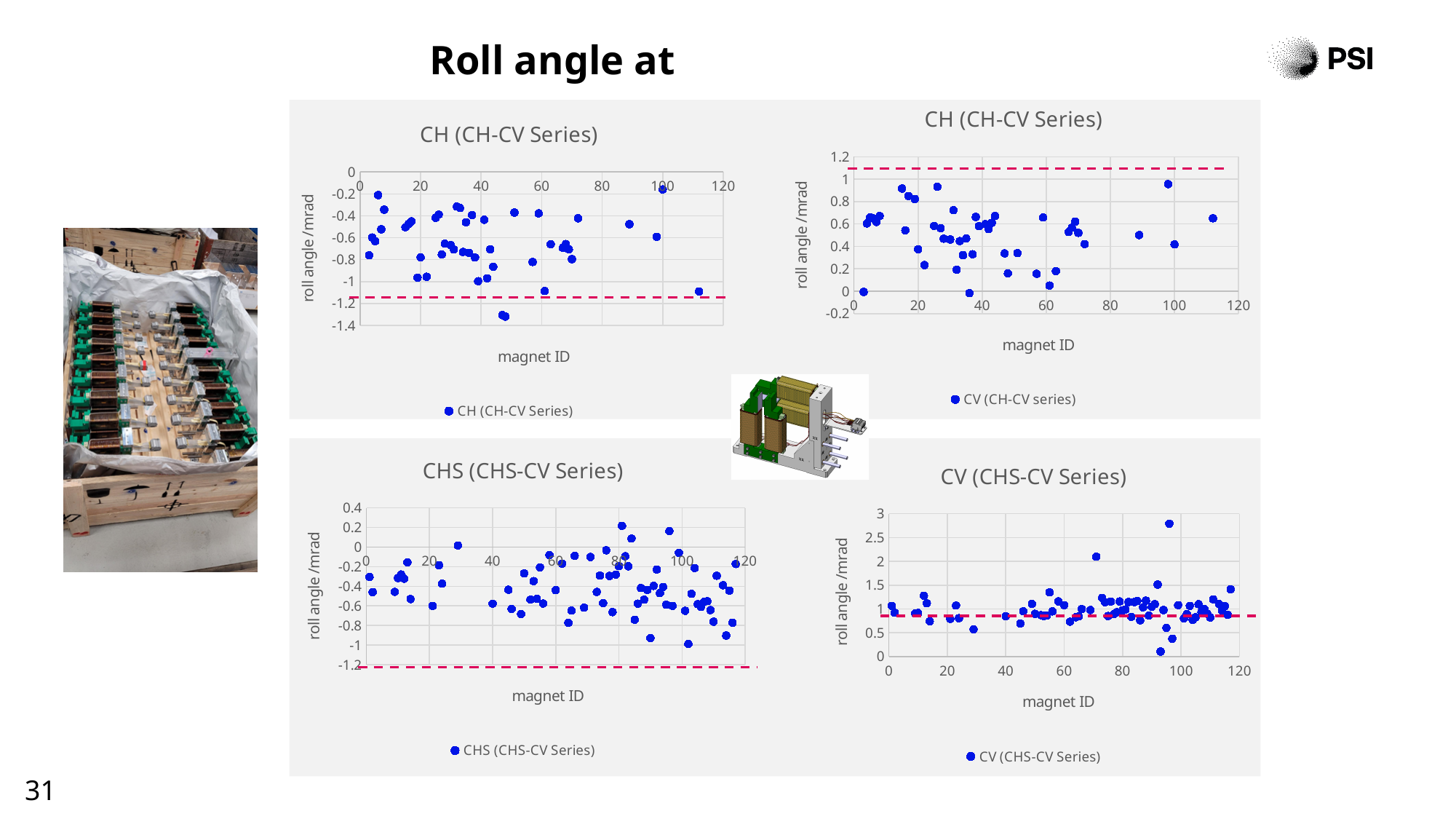
What is the x-axis label of the bottom-left chart "CHS (CHS-CV Series)"? magnet ID In the top-left chart "CH (CH-CV Series)", is the lowest plotted roll angle greater or less than -1.2? less In the bottom-right chart "CV (CHS-CV Series)", is the lowest plotted roll angle greater or less than 0.5? less In the top-right chart, is the highest plotted roll angle greater or less than 0.8? greater What kind of chart is the top-left chart titled "CH (CH-CV Series)"? scatter chart How many series does the legend of the top-left chart "CH (CH-CV Series)" list? 1 What kind of chart is the bottom-right chart "CV (CHS-CV Series)"? scatter chart How many series does the legend of the bottom-right chart "CV (CHS-CV Series)" list? 1 What is the y-axis label of the top-right chart? roll angle /mrad